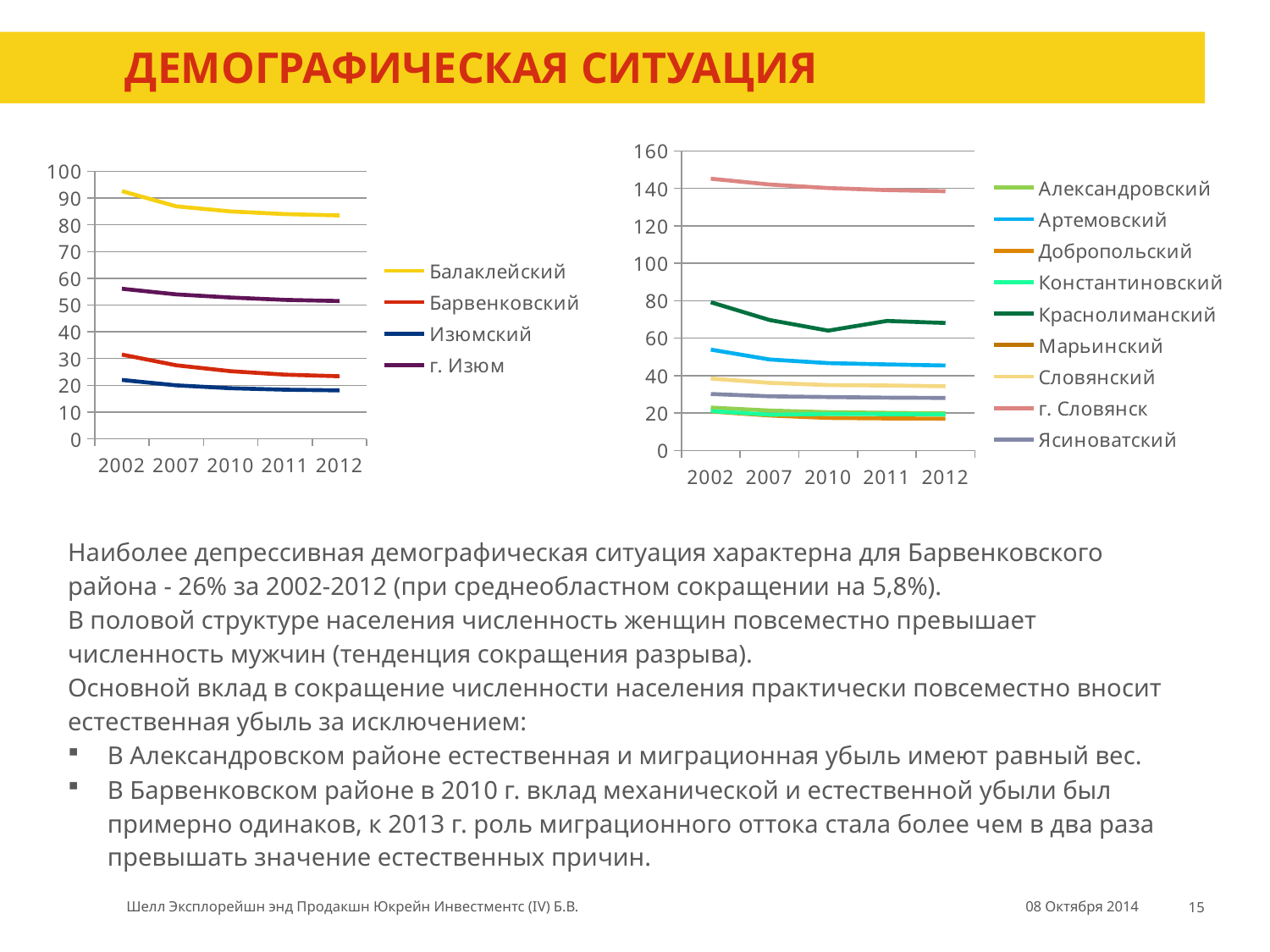
In the right chart, is the value for Артемовский in 2012 greater or less than 60? less In the left chart, does the Балаклейский line rise or fall from 2002 to 2012? fall In the left chart, which series has the lowest values? Изюмский In the left chart, which series has the highest values? Балаклейский What kind of chart is the chart on the left of the slide? line chart In the left chart, is the value for Балаклейский in 2002 greater or less than 80? greater How many series does the legend of the left chart list? 4 In the right chart, which is larger in 2002: Краснолиманский or Артемовский? Краснолиманский How many series does the legend of the right chart list? 9 In the right chart, is the value for г. Словянск in 2012 greater or less than 120? greater In the right chart, which series has the highest values? г. Словянск How many years are shown on the x axis of the left chart? 5